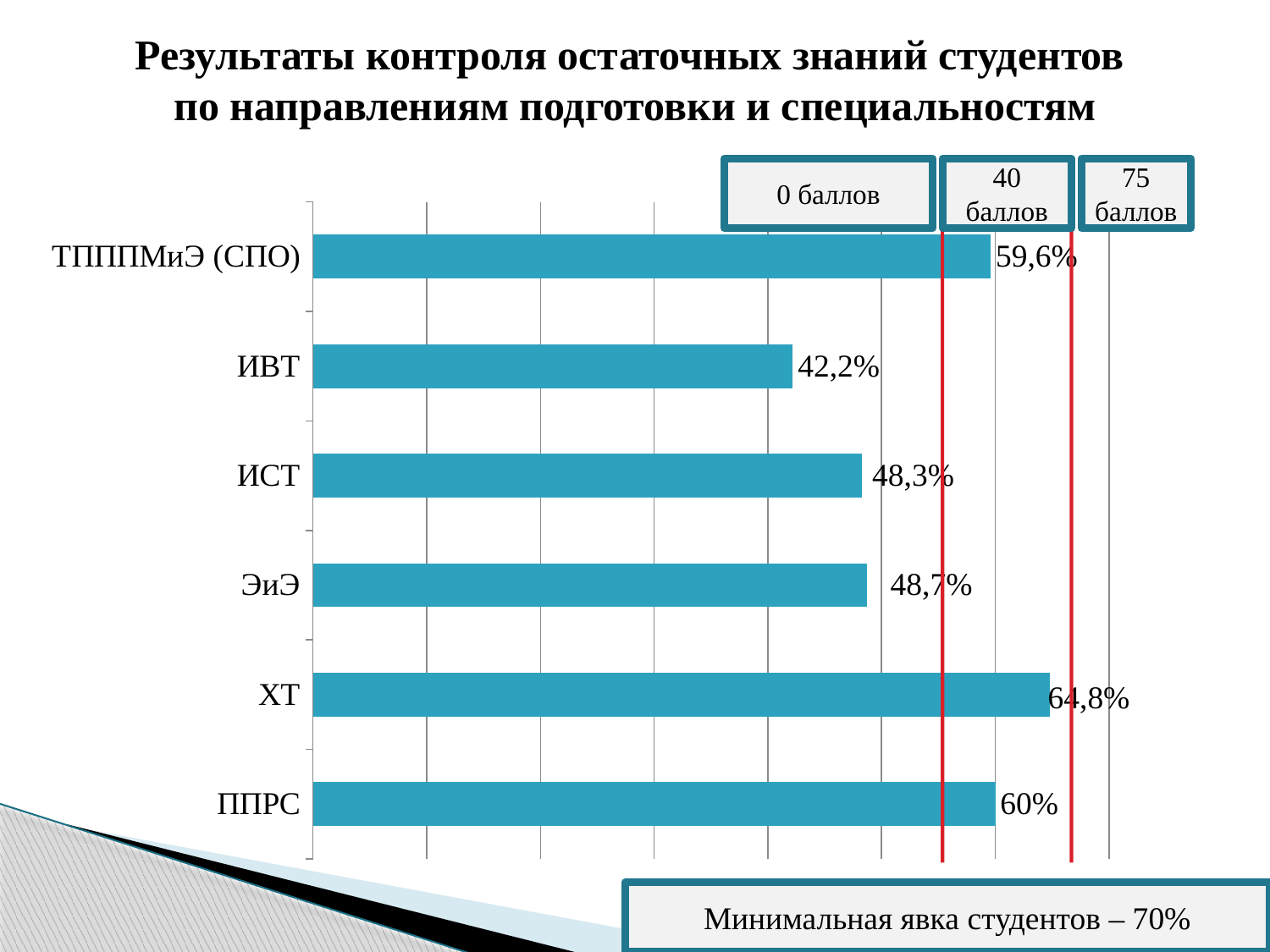
What kind of chart is shown on the slide? Bar chart What is the value for ИВТ? 42,2% What is the value for ХТ? 64,8% What is the value for ТПППМиЭ (СПО)? 59,6% Which category has the highest value? ХТ What is the value for ППРС? 60% How many categories are shown in the chart? 6 What is the difference between the values for ХТ and ИВТ? 22,6% Which category has the lowest value? ИВТ What minimum student attendance is stated in the box below the chart? 70% Which is larger, the value for ИСТ or the value for ИВТ? ИСТ What is the difference between the values for ППРС and ТПППМиЭ (СПО)? 0,4%